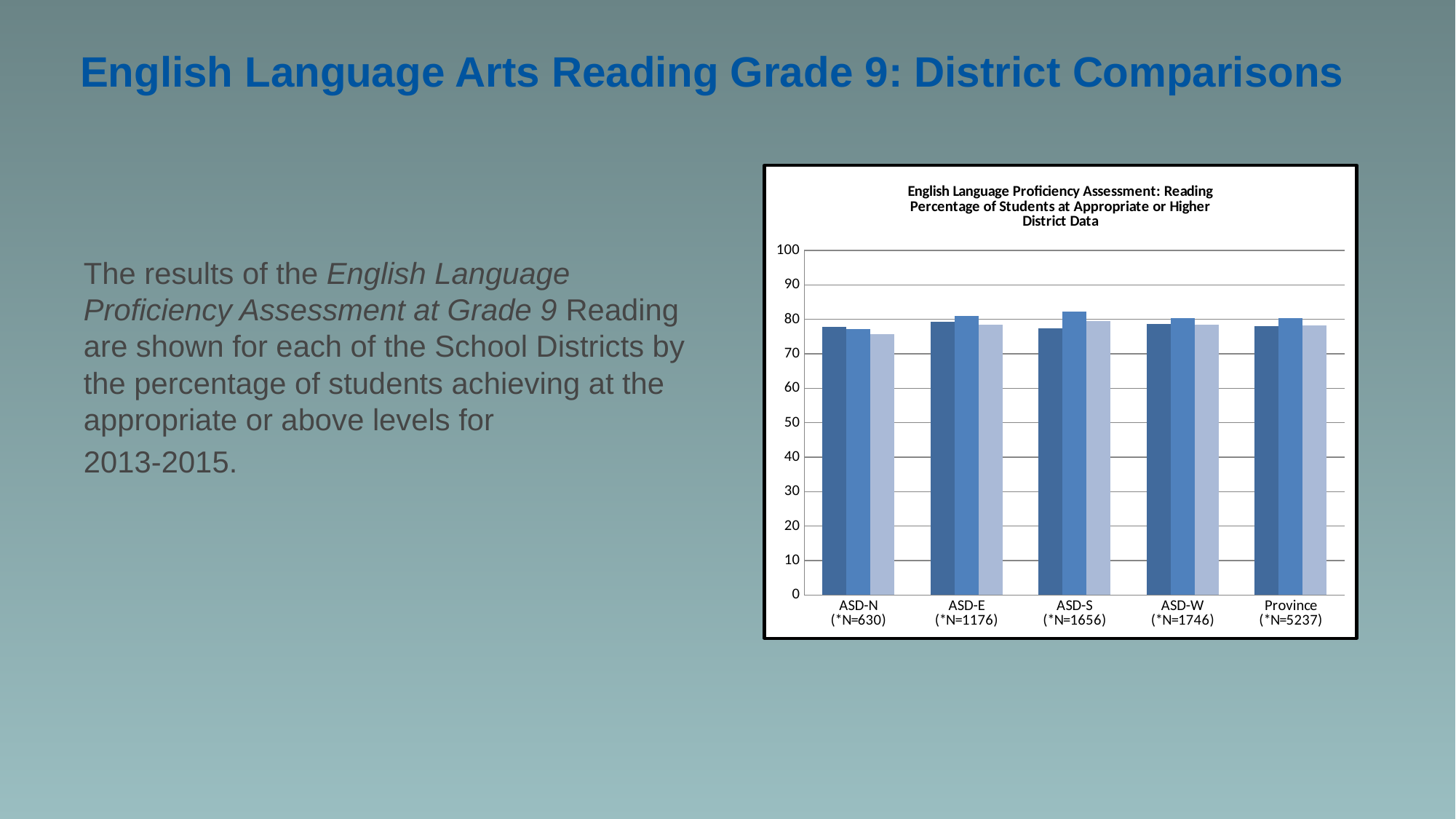
What is the sample size (N) shown for ASD-N on the x axis? *N=630 What is the title of the chart? English Language Proficiency Assessment: Reading Percentage of Students at Appropriate or Higher District Data What kind of chart is shown on the slide? bar chart Is the value of the first bar for ASD-W greater or less than 90? less How many districts (categories) are shown on the x axis of the chart? 5 Is the value of the middle bar for ASD-E greater or less than 50? greater Is the value of the third bar for Province greater or less than 60? greater What is the maximum value shown on the y axis of the chart? 100 How many bars are plotted for each district in the chart? 3